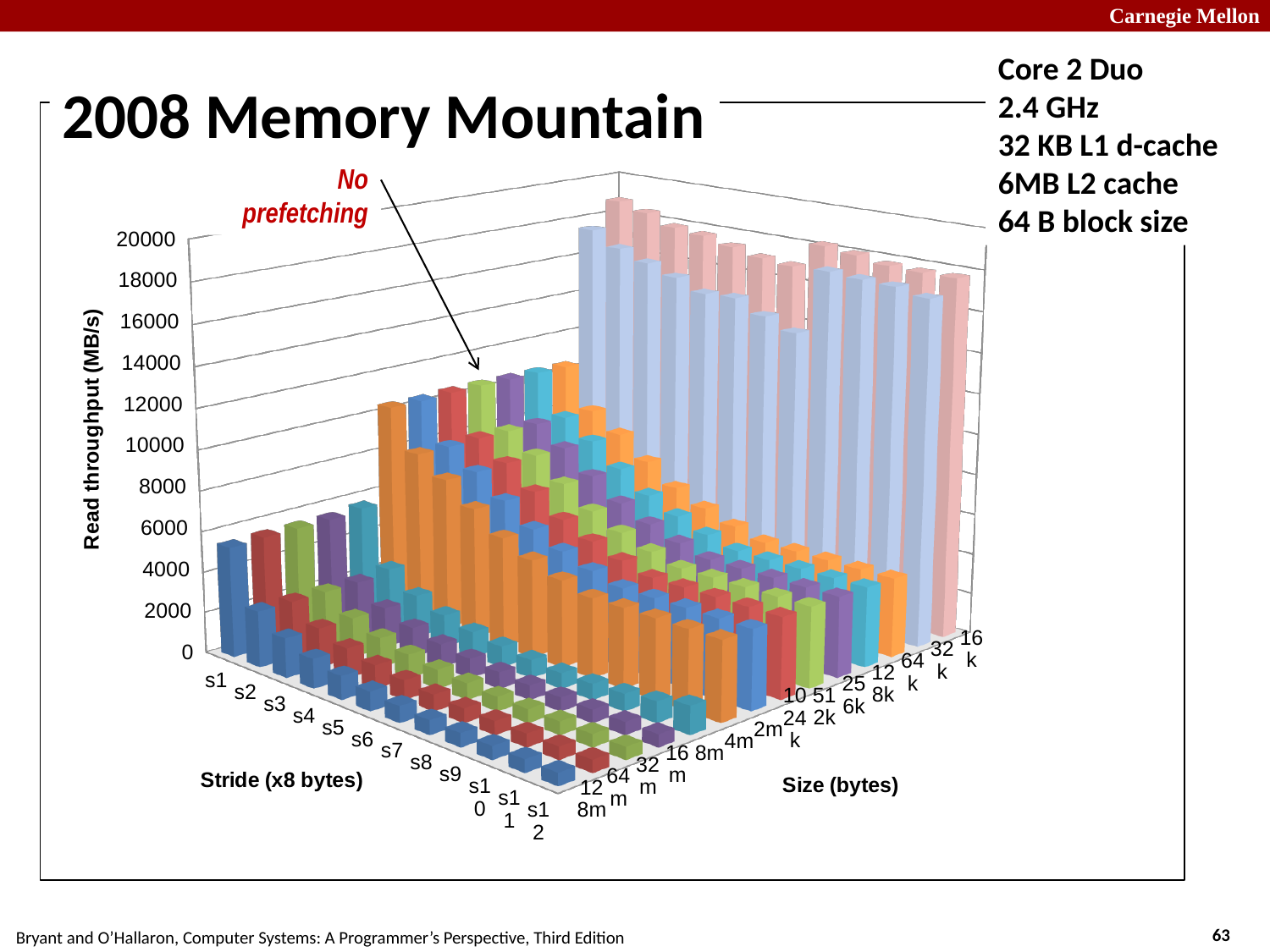
For stride s1, does read throughput generally rise or fall as the size decreases from 128m to 16k? rise What is the title of the chart? 2008 Memory Mountain What is the label of the vertical axis? Read throughput (MB/s) How many stride categories (s1 through s12) are shown on the stride axis? 12 Is the read throughput for stride s1 at size 16k greater or less than 14000 MB/s? greater Is the read throughput for stride s12 at size 128m greater or less than 4000 MB/s? less Is the read throughput for stride s1 at size 128m greater or less than 8000 MB/s? less What kind of chart is shown on the slide? 3D bar chart What is the highest tick value shown on the Read throughput axis? 20000 How many size categories are shown on the Size (bytes) axis? 14 Which stride has the highest read throughput values on the chart? s1 For a fixed size, does read throughput generally rise or fall as the stride increases from s1 to s12? fall